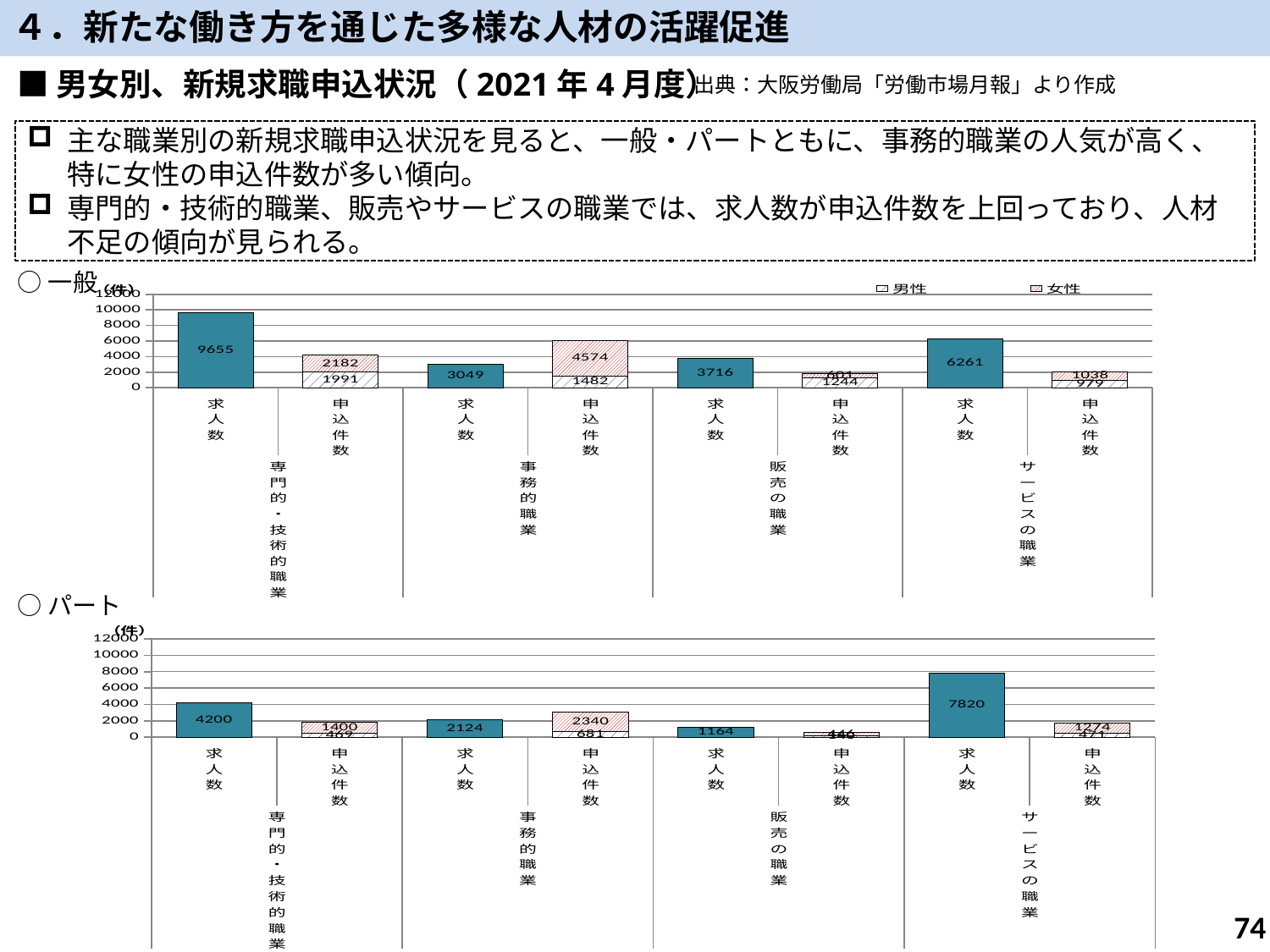
In the bottom chart (パート), which occupation has the lowest 求人数? 販売の職業 In the top chart (一般), what is the total 申込件数 (男性 + 女性) for 事務的職業? 6056 In the top chart (一般), what is the 求人数 value for サービスの職業? 6261 In the bottom chart (パート), which is larger: the 求人数 for 専門的・技術的職業 or for 事務的職業? 専門的・技術的職業 In the bottom chart (パート), what is the 女性 申込件数 value for 事務的職業? 2340 In the bottom chart (パート), what is the 求人数 value for サービスの職業? 7820 How many series does the legend of the top chart (一般) list? 2 In the top chart (一般), what is the 女性 申込件数 value for 事務的職業? 4574 In the top chart (一般), what is the 求人数 value for 専門的・技術的職業? 9655 In the top chart (一般), what is the difference between the 求人数 for 専門的・技術的職業 and for 事務的職業? 6606 In the top chart (一般), which occupation has the highest 求人数? 専門的・技術的職業 In the bottom chart (パート), what is the total 申込件数 (男性 + 女性) for 専門的・技術的職業? 1869